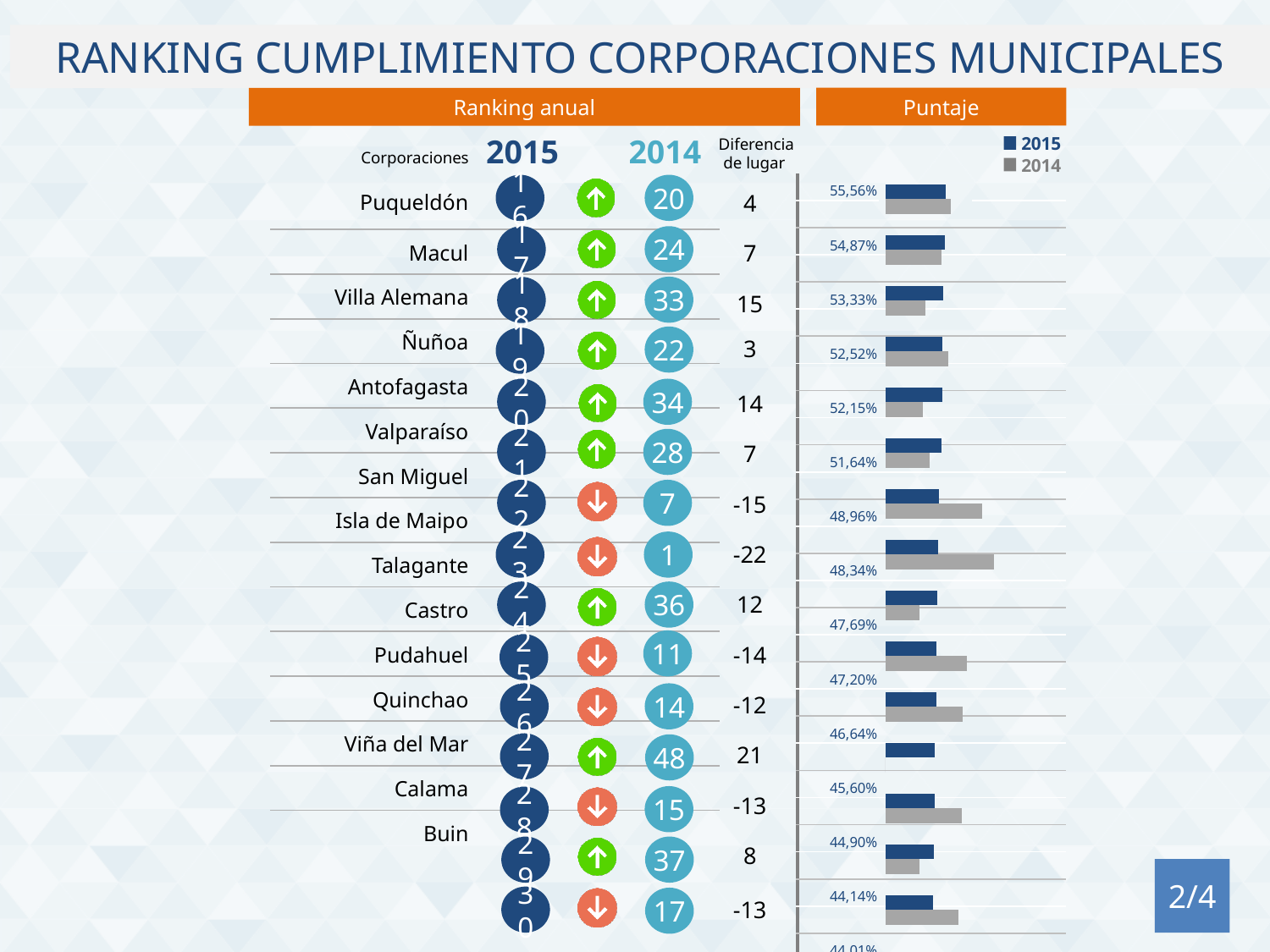
In the Puntaje bar chart, what is the difference between the 2015 values of Puqueldón and Macul? 0,69 percentage points How many series does the legend of the Puntaje chart list? 2 In the Puntaje bar chart, do the 2015 values increase or decrease going down the list from Puqueldón to Calama? Decrease In the Puntaje bar chart, what is the 2015 value for Castro? 47,20% In the Puntaje bar chart, which corporation has the highest 2015 value? Puqueldón In the Puntaje bar chart, for Villa Alemana, which bar is longer: 2015 or 2014? 2015 In the Puntaje bar chart, for Isla de Maipo, which bar is longer: 2015 or 2014? 2014 In the Puntaje bar chart, what is the 2015 value for Puqueldón? 55,56% In the Puntaje chart legend, which colour represents 2014? Grey In the Puntaje bar chart, what is the 2015 value for Villa Alemana? 53,33% In the Puntaje bar chart, what is the 2015 value for Macul? 54,87% What kind of chart is the Puntaje chart? Bar chart